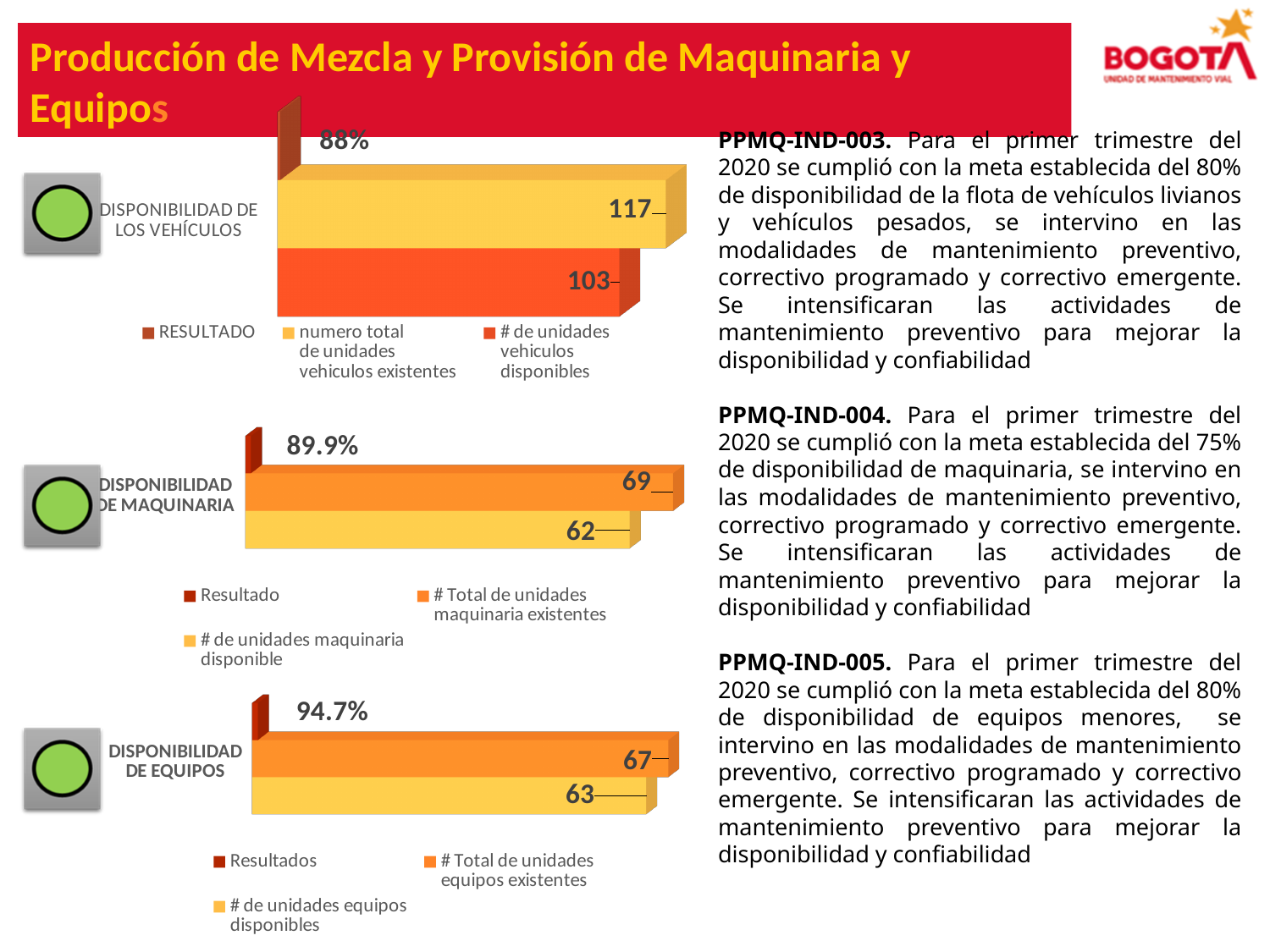
In the top chart (Disponibilidad de los vehículos), what is the RESULTADO value shown? 88% In the bottom chart (Disponibilidad de equipos), what is the value for '# de unidades equipos disponibles'? 63 In the bottom chart (Disponibilidad de equipos), which is larger: '# Total de unidades equipos existentes' or '# de unidades equipos disponibles'? # Total de unidades equipos existentes In the top chart (Disponibilidad de los vehículos), what is the value for 'numero total de unidades vehiculos existentes'? 117 In the top chart (Disponibilidad de los vehículos), what is the value for '# de unidades vehiculos disponibles'? 103 In the top chart (Disponibilidad de los vehículos), what is the difference between the total number of existing vehicles and the number of available vehicles? 14 How many series does the legend of the middle chart (Disponibilidad de maquinaria) list? 3 In the middle chart (Disponibilidad de maquinaria), what is the Resultado value shown? 89.9% In the middle chart (Disponibilidad de maquinaria), what is the value for '# Total de unidades maquinaria existentes'? 69 In the bottom chart (Disponibilidad de equipos), what is the Resultados value shown? 94.7% In the middle chart (Disponibilidad de maquinaria), what is the difference between the total machinery units and the available machinery units? 7 What kind of chart is the bottom chart (Disponibilidad de equipos)? Bar chart